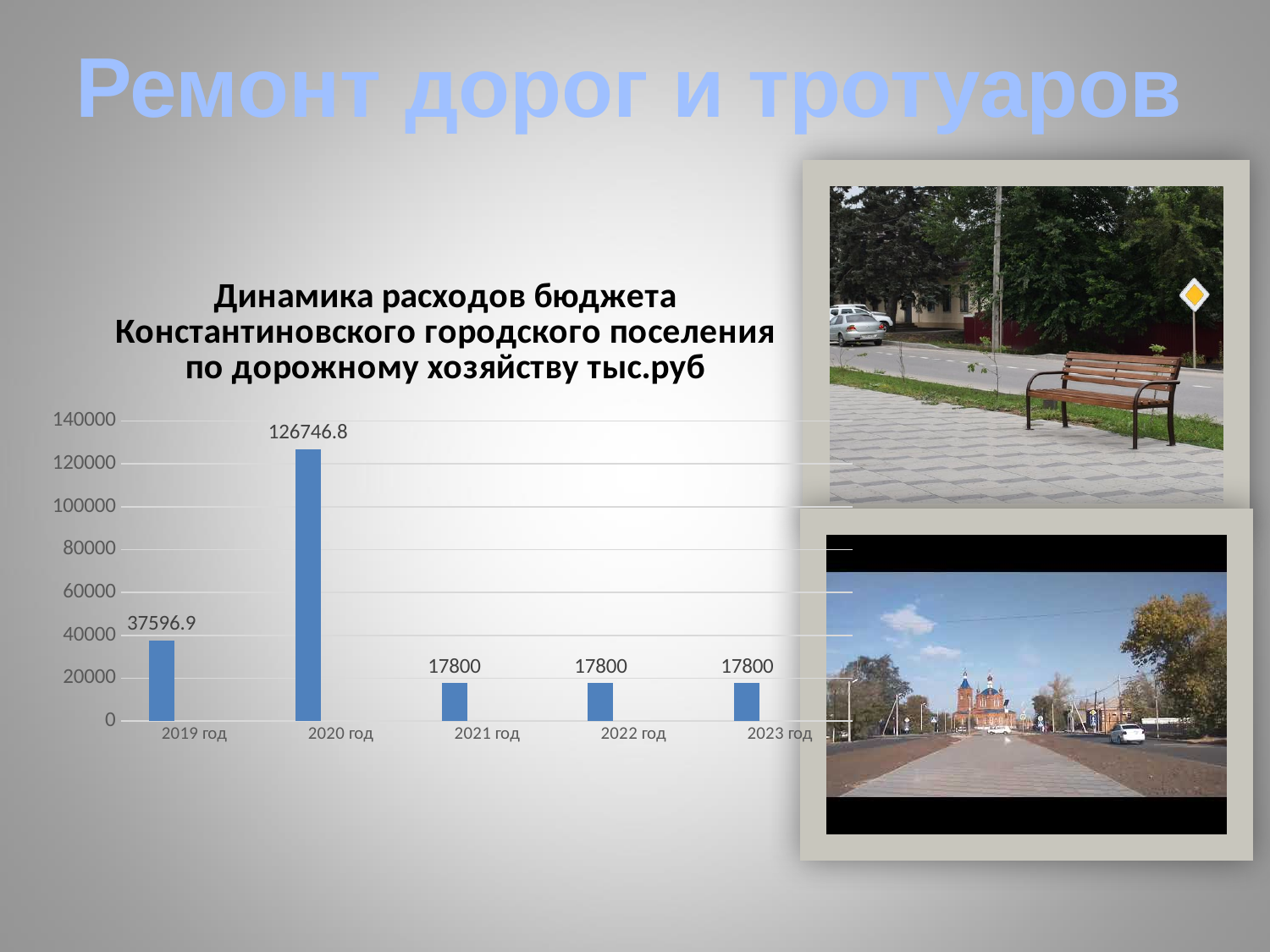
What is the value for 2020 год? 126746.8 What is the difference between the values for 2019 год and 2021 год? 19796.9 What is the lowest value shown in the chart? 17800 Which year has the highest value? 2020 год What is the value for 2019 год? 37596.9 Which is larger, the value for 2019 год or the value for 2023 год? 2019 год What is the difference between the values for 2020 год and 2019 год? 89149.9 What is the value for 2022 год? 17800 Is the value for 2020 год greater or less than 120000? greater What kind of chart is shown on the slide? bar chart How many years are shown on the x axis? 5 Do the values rise or fall from 2020 год to 2021 год? fall